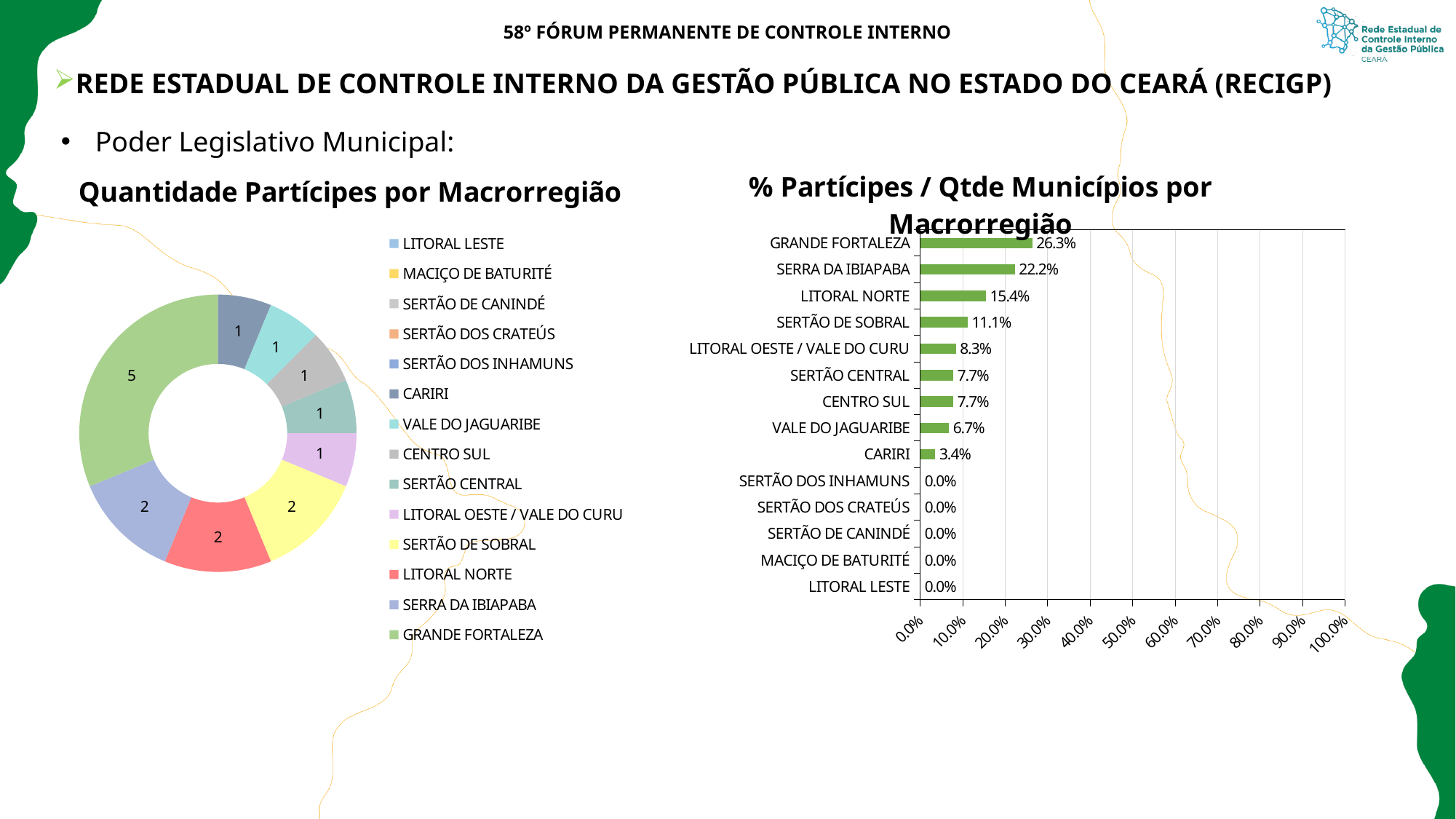
In the chart titled "% Partícipes / Qtde Municípios por Macrorregião", what is the difference between SERRA DA IBIAPABA and SERTÃO DE SOBRAL? 11.1% In the chart titled "% Partícipes / Qtde Municípios por Macrorregião", which is larger, CARIRI or VALE DO JAGUARIBE? VALE DO JAGUARIBE In the chart titled "% Partícipes / Qtde Municípios por Macrorregião", how many macrorregiões have a value of 0.0%? 5 What kind of chart is "Quantidade Partícipes por Macrorregião"? Doughnut chart In the chart titled "% Partícipes / Qtde Municípios por Macrorregião", how many categories are shown on the vertical axis? 14 In the chart titled "Quantidade Partícipes por Macrorregião", what is the value for GRANDE FORTALEZA? 5 In the chart titled "% Partícipes / Qtde Municípios por Macrorregião", which macrorregião has the highest value? GRANDE FORTALEZA In the chart titled "% Partícipes / Qtde Municípios por Macrorregião", what is the value for GRANDE FORTALEZA? 26.3% In the chart titled "Quantidade Partícipes por Macrorregião", what is the value for LITORAL NORTE? 2 What kind of chart is "% Partícipes / Qtde Municípios por Macrorregião"? Bar chart In the chart titled "% Partícipes / Qtde Municípios por Macrorregião", what is the value for LITORAL NORTE? 15.4% In the chart titled "Quantidade Partícipes por Macrorregião", how many entries does the legend list? 14